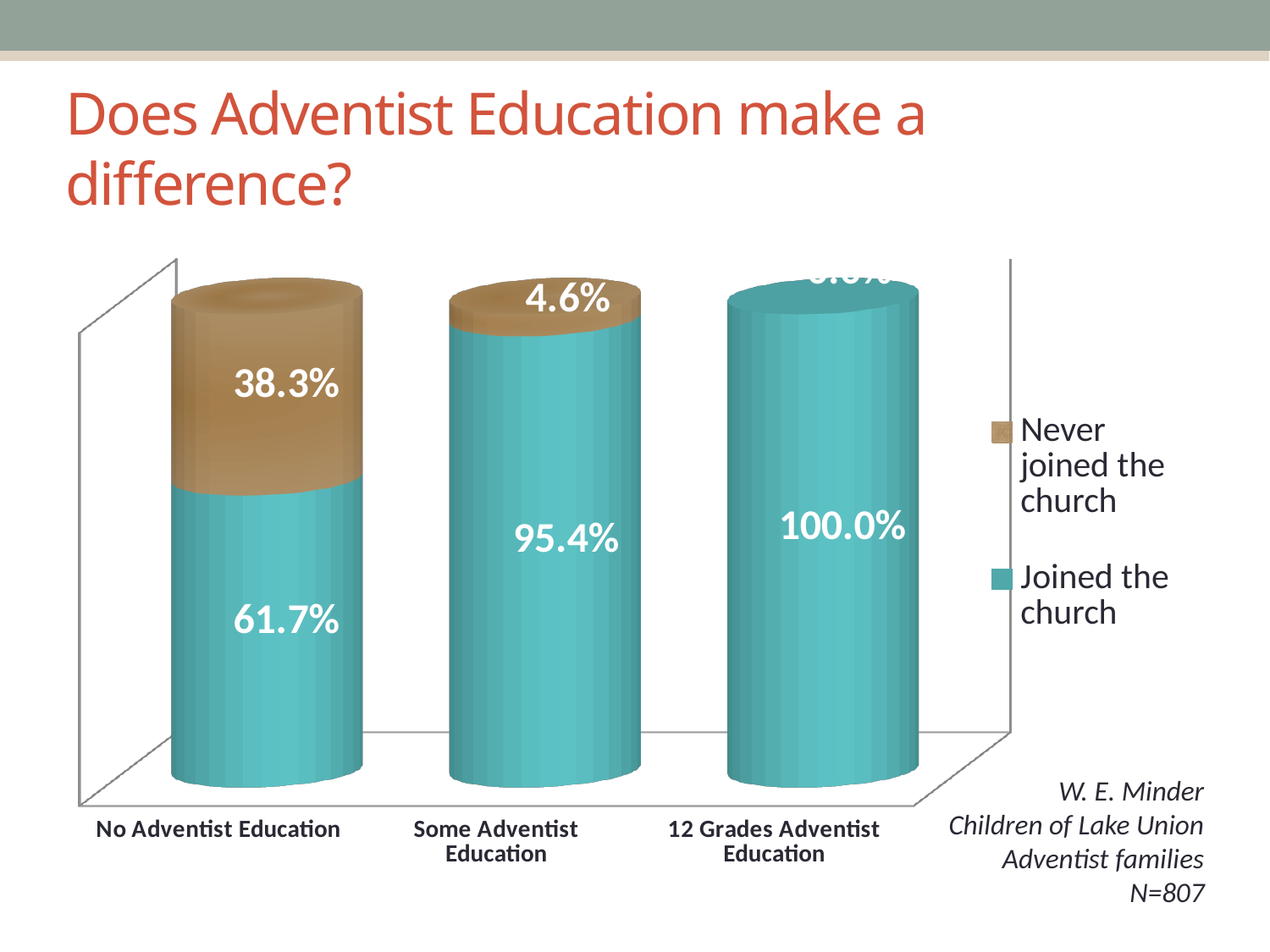
How many education categories are shown on the x axis? 3 What percentage of children with Some Adventist Education never joined the church? 4.6% What is the difference between the 'Joined the church' percentages for Some Adventist Education and No Adventist Education? 33.7% Which education category has the highest share of children who joined the church? 12 Grades Adventist Education What percentage of children with 12 Grades Adventist Education joined the church? 100.0% Which is larger: the 'Never joined the church' share for No Adventist Education or for Some Adventist Education? No Adventist Education What percentage of children with Some Adventist Education joined the church? 95.4% Which education category has the lowest share of children who joined the church? No Adventist Education How many series does the legend list? 2 What percentage of children with No Adventist Education joined the church? 61.7% What kind of chart is shown on the slide? Stacked bar chart What percentage of children with No Adventist Education never joined the church? 38.3%